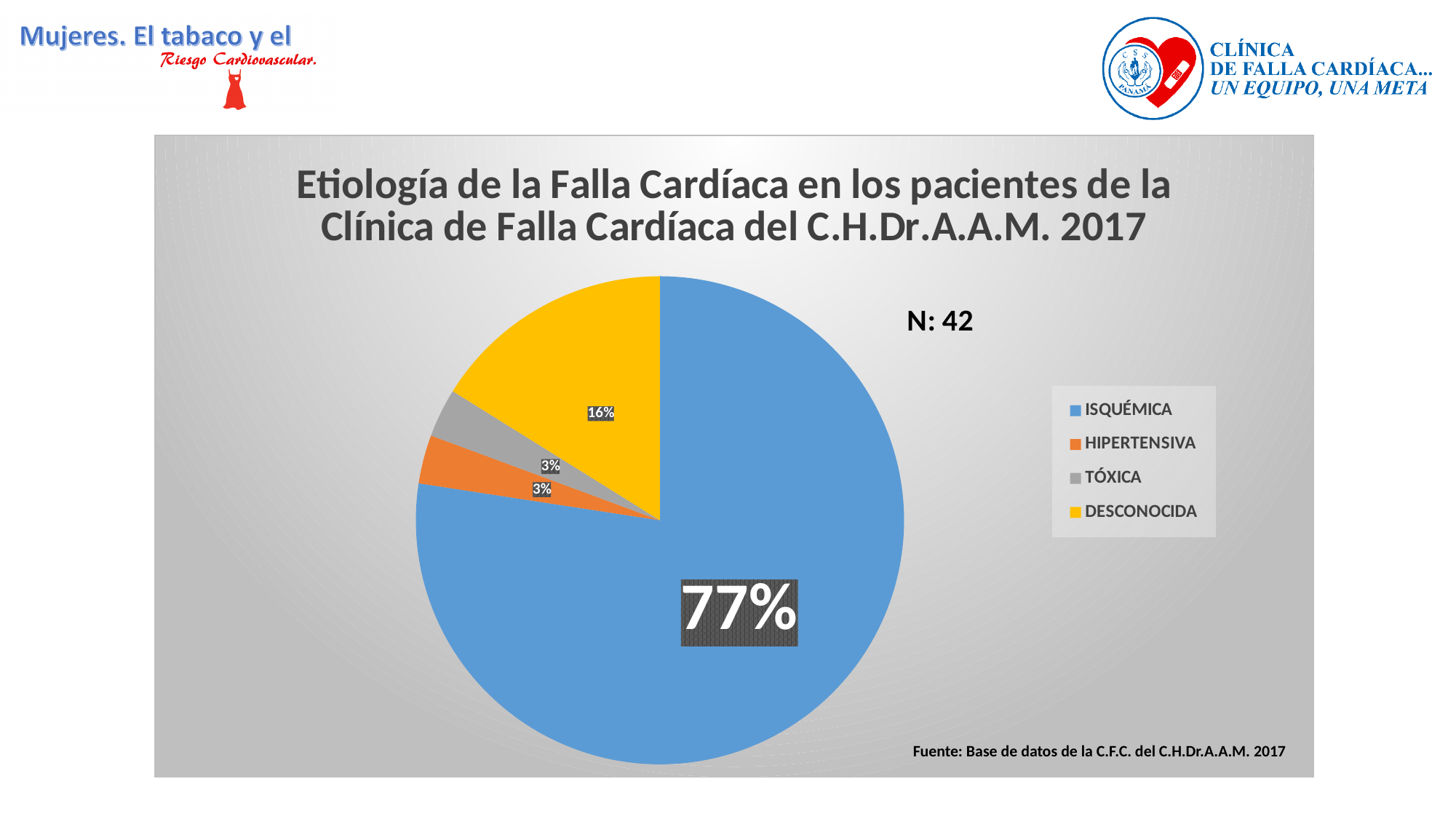
How many categories does the legend list? 4 What is the title of the chart? Etiología de la Falla Cardíaca en los pacientes de la Clínica de Falla Cardíaca del C.H.Dr.A.A.M. 2017 What share of the pie does DESCONOCIDA represent? 16% What is the difference between the share for ISQUÉMICA and the share for DESCONOCIDA? 61% Which is larger, the share for DESCONOCIDA or the share for HIPERTENSIVA? DESCONOCIDA Which category has the largest slice of the pie? ISQUÉMICA What share of the pie does ISQUÉMICA represent? 77% What colour is the slice for DESCONOCIDA? yellow What kind of chart is shown on the slide? pie chart What is the sample size (N) shown on the chart? 42 What share of the pie does HIPERTENSIVA represent? 3%